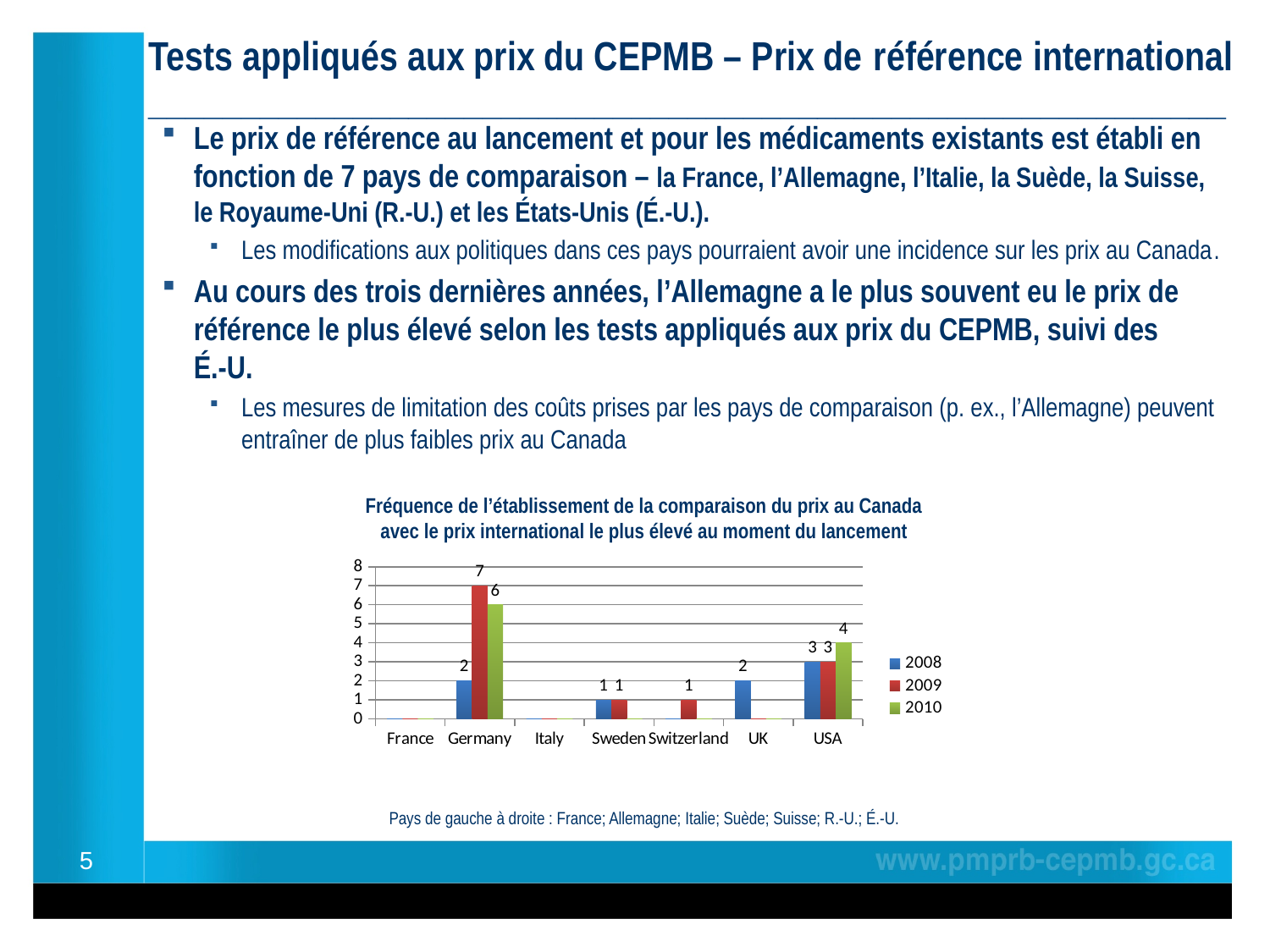
How many countries are shown on the x axis of the chart? 7 What is the difference between the 2009 and 2010 values for Germany? 1 Is the 2009 value for Germany greater or less than 5? greater Which is larger for USA, the 2008 value or the 2010 value? 2010 Which country has the highest 2009 value? Germany What is the 2008 value for Sweden? 1 What is the 2008 value for UK? 2 How many series does the chart legend list? 3 What is the 2009 value for Germany? 7 What type of chart is shown on the slide? bar chart Which series is shown in green in the chart legend? 2010 What is the 2010 value for USA? 4